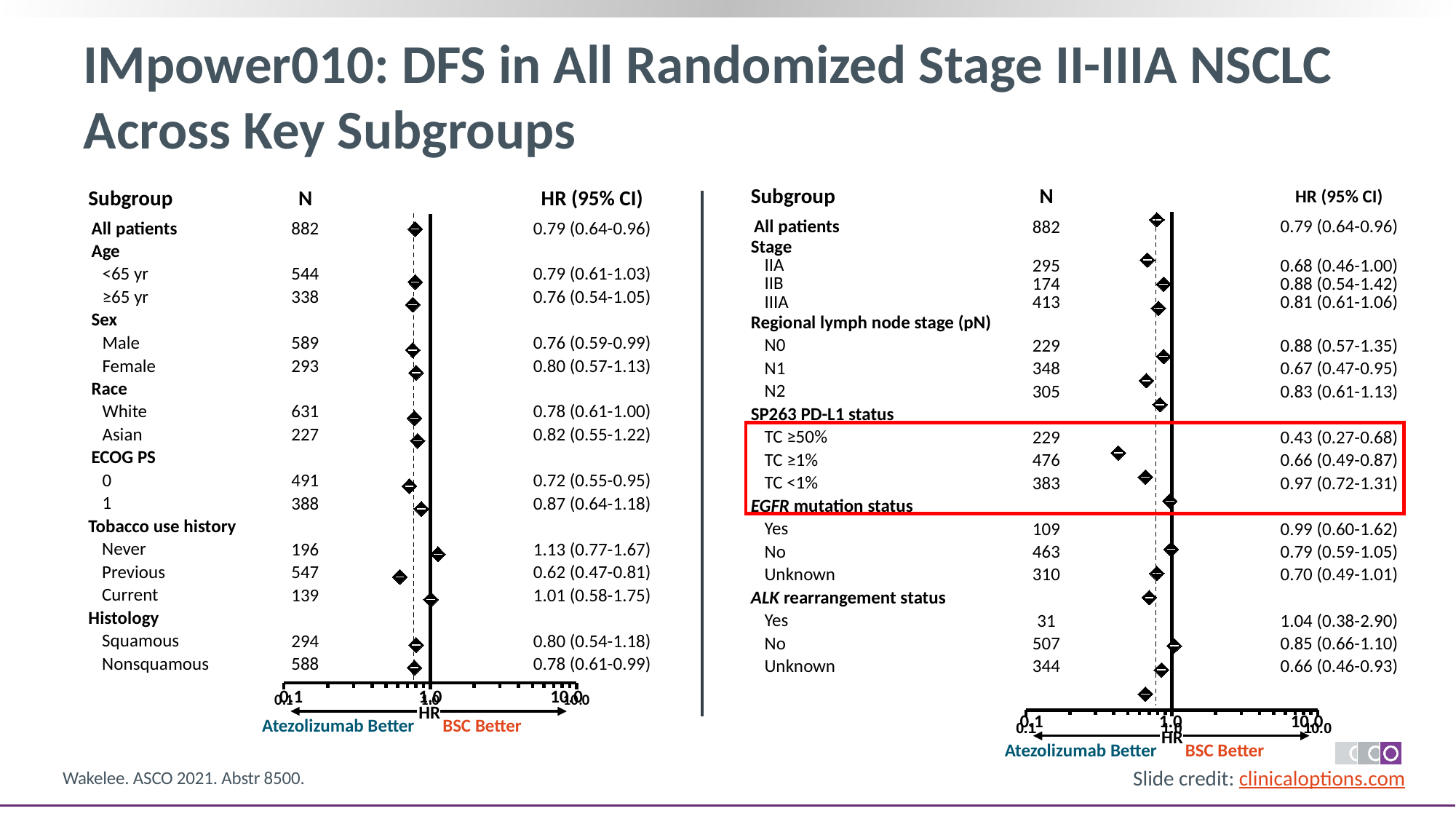
In the right chart, how many subgroups are listed under SP263 PD-L1 status? 3 What kind of chart is shown on the slide? Forest plot In the left chart, which has the larger hazard ratio, Male or Female? Female In the left chart, what is the HR (95% CI) for the Never tobacco use subgroup? 1.13 (0.77-1.67) In the right chart, which subgroup has the lowest hazard ratio? TC ≥50% In the left chart, which subgroup has the highest hazard ratio? Never (tobacco use) In the right chart, what is the difference between the hazard ratios for TC <1% and TC ≥50%? 0.54 In the right chart, what is the HR (95% CI) for the TC ≥50% subgroup? 0.43 (0.27-0.68) In the left chart, what is the HR (95% CI) for All patients? 0.79 (0.64-0.96) In the right chart, which subgroup has the highest hazard ratio? ALK rearrangement Yes In the left chart, which subgroup has the lowest hazard ratio? Previous (tobacco use) In the right chart, what is the N for the TC ≥1% subgroup? 476